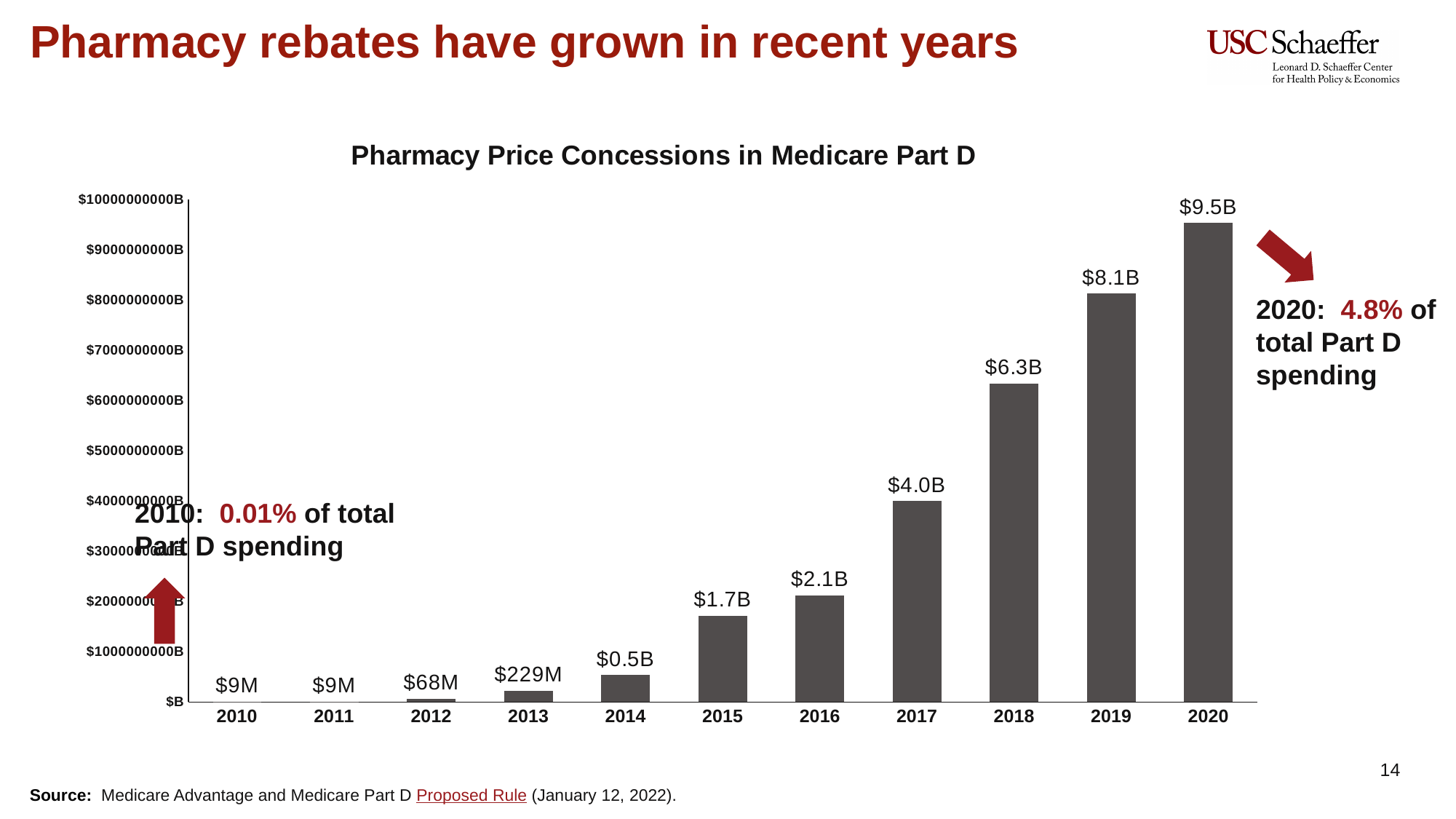
Do the values in the chart rise or fall from 2010 to 2020? Rise What is the value for 2013 in the chart? $229M What is the difference between the 2018 and 2017 values in the chart? $2.3B What is the difference between the 2020 and 2019 values in the chart? $1.4B What kind of chart is shown on the slide? Bar chart What is the title of the chart on the slide? Pharmacy Price Concessions in Medicare Part D What is the value for 2020 in the Pharmacy Price Concessions in Medicare Part D chart? $9.5B What is the value for 2012 in the chart? $68M Which year has the highest pharmacy price concessions in the chart? 2020 What is the value for 2016 in the chart? $2.1B How many years are shown on the x axis of the chart? 11 Which is larger in the chart, the value for 2015 or the value for 2017? 2017